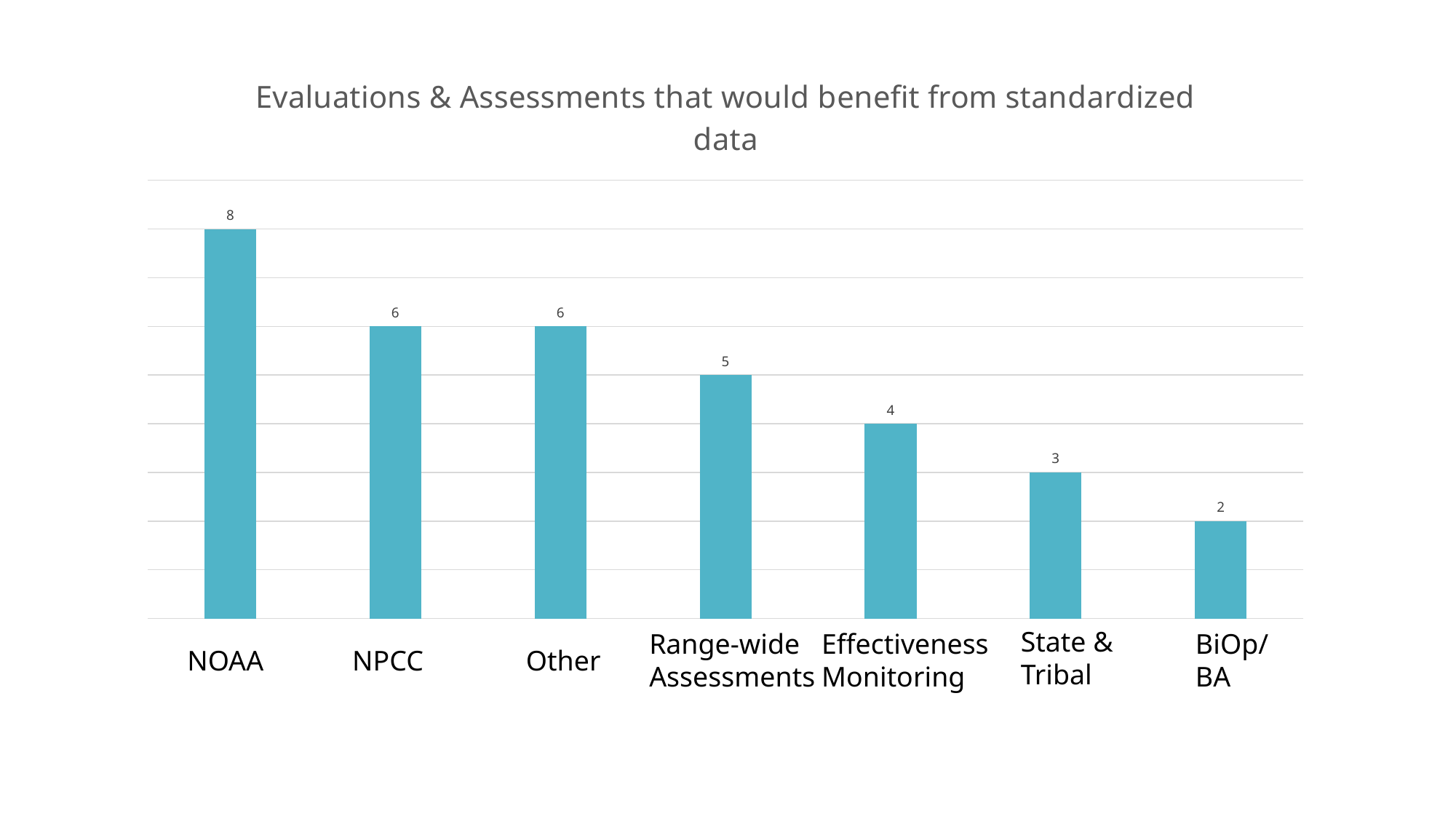
What is the difference between the values for NPCC and BiOp/BA? 4 What is the title of the chart? Evaluations & Assessments that would benefit from standardized data Which category has the lowest value? BiOp/BA What is the value for BiOp/BA? 2 Which is larger, the value for Other or the value for Effectiveness Monitoring? Other Which category has the highest value? NOAA What is the value for Range-wide Assessments? 5 What kind of chart is this? Bar chart What is the value for NOAA? 8 What is the difference between the values for NOAA and State & Tribal? 5 How many categories are shown in the chart? 7 What is the value for Effectiveness Monitoring? 4